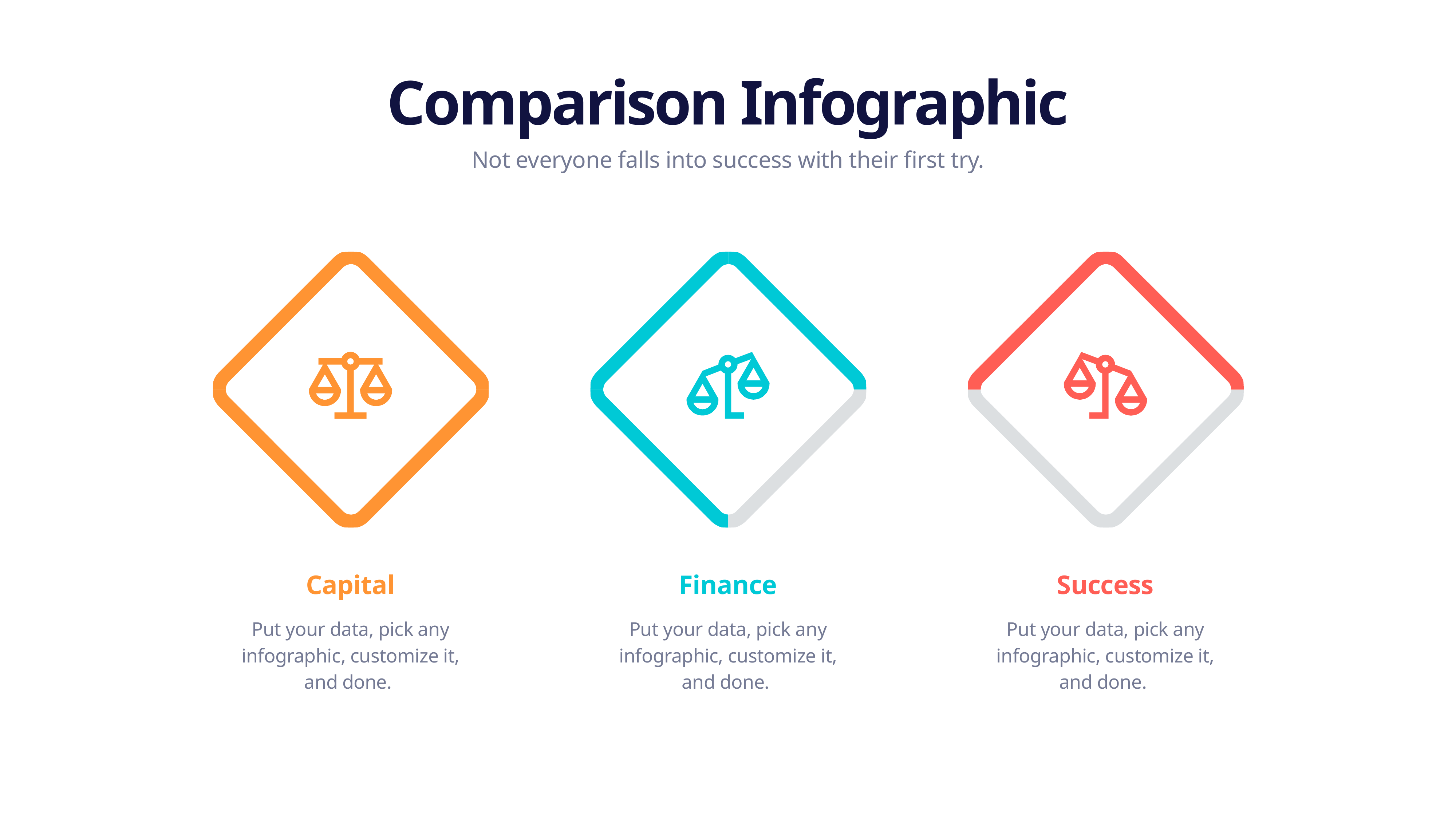
Which item has the smallest filled portion of its diamond ring? Success Which item has the largest filled portion of its diamond ring? Capital Which has a larger filled portion of its ring, Capital or Success? Capital How many comparison items are shown on the slide? 3 Which has a larger filled portion of its ring, Finance or Success? Finance What colour is the ring for Capital? Orange What is the title of the slide? Comparison Infographic